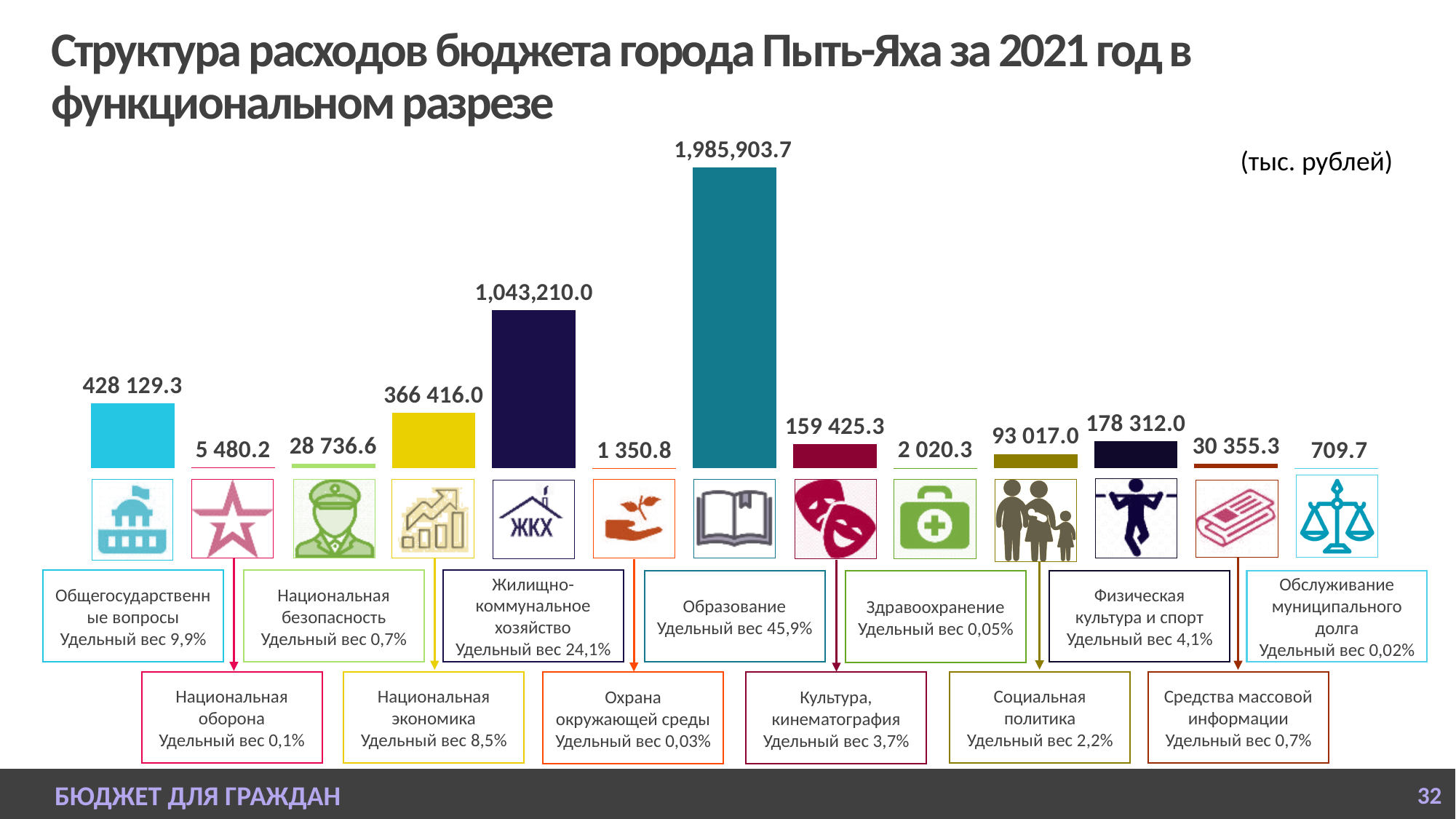
What unit is stated for the values in the chart? тыс. рублей What kind of chart is shown on the slide? Bar chart What is the difference between the values for Образование and Жилищно-коммунальное хозяйство? 942,693.7 How many categories are shown in the chart? 13 What is the value for Образование? 1,985,903.7 What is the value for Жилищно-коммунальное хозяйство? 1,043,210.0 What is the value for Обслуживание муниципального долга? 709.7 Which category has the highest value? Образование What is the value for Социальная политика? 93 017.0 What is the value for Национальная экономика? 366 416.0 Which is larger, the value for Физическая культура и спорт or the value for Культура, кинематография? Физическая культура и спорт Which category has the lowest value? Обслуживание муниципального долга